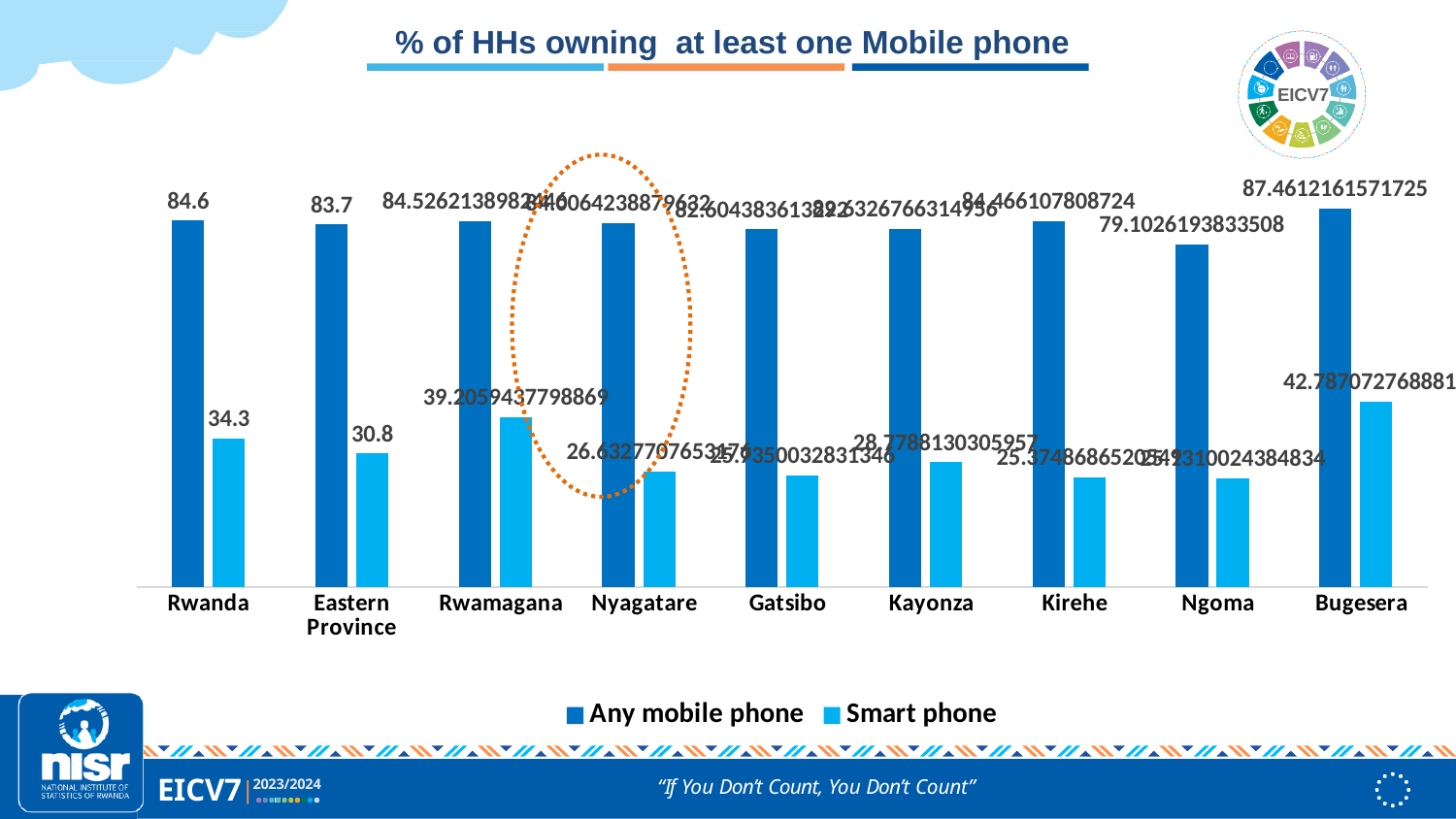
What is the difference between Any mobile phone and Smart phone in Rwanda? 50.3 What is the value for Smart phone in Rwanda? 34.3 Which category has the lowest value for Any mobile phone? Ngoma Which is larger: the Smart phone value for Rwamagana or for Eastern Province? Rwamagana What is the value for Any mobile phone in Rwanda? 84.6 What is the value for Smart phone in Bugesera? 42.787072768881 What is the value for Smart phone in Eastern Province? 30.8 How many categories are shown on the x axis? 9 Which category has the highest value for Any mobile phone? Bugesera Which category has the highest value for Smart phone? Bugesera How many series does the legend list? 2 What is the value for Any mobile phone in Ngoma? 79.1026193833508